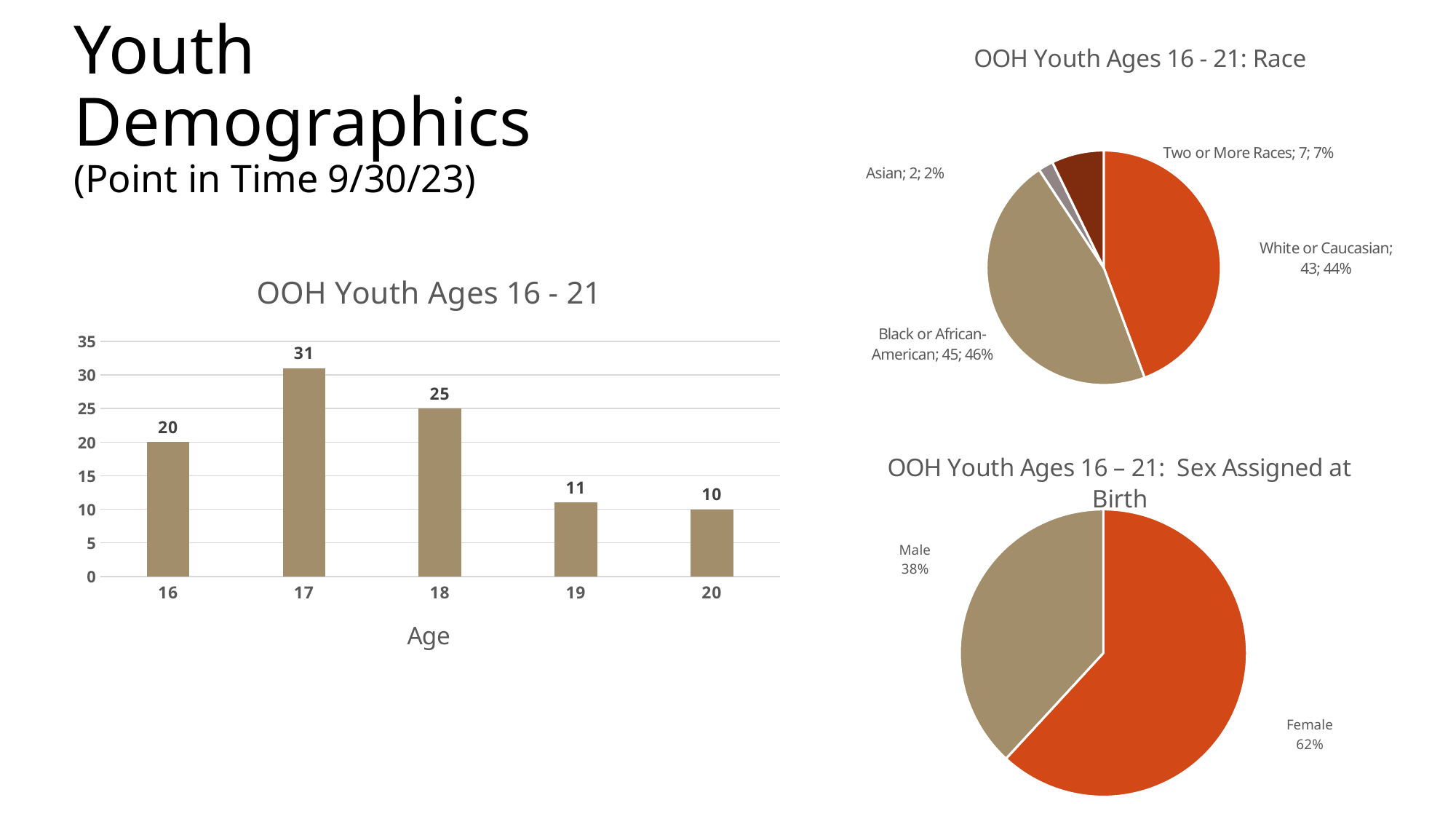
In the 'OOH Youth Ages 16 - 21' bar chart, is the value for age 16 larger than the value for age 20? Yes What kind of chart is 'OOH Youth Ages 16 - 21' on the left of the slide? bar chart In the 'OOH Youth Ages 16 - 21' bar chart, what is the value for age 17? 31 In the 'OOH Youth Ages 16 - 21: Race' pie chart, how many race categories are shown? 4 In the 'OOH Youth Ages 16 - 21' bar chart, what is the difference between the values for age 18 and age 19? 14 In the 'OOH Youth Ages 16 - 21' bar chart, how many age categories are shown? 5 In the 'OOH Youth Ages 16 - 21: Race' pie chart, what share does White or Caucasian represent? 44% In the 'OOH Youth Ages 16 - 21' bar chart, which age has the highest value? 17 In the 'OOH Youth Ages 16 - 21' bar chart, which age has the lowest value? 20 In the 'OOH Youth Ages 16 – 21: Sex Assigned at Birth' pie chart, what share is Male? 38% In the 'OOH Youth Ages 16 - 21: Race' pie chart, which race has the smallest slice? Asian In the 'OOH Youth Ages 16 - 21: Race' pie chart, what is the count for Black or African-American? 45